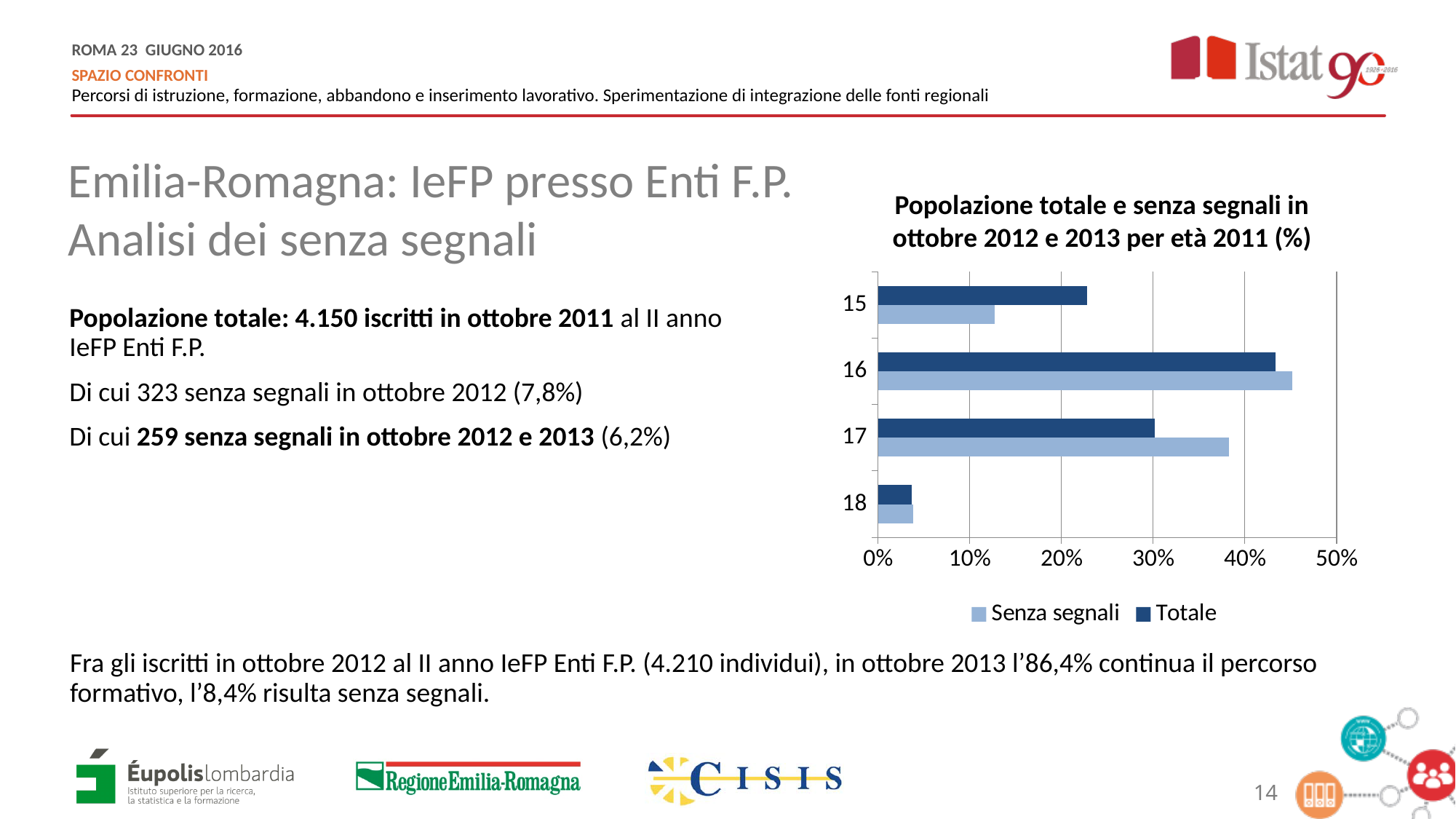
How many series does the chart legend list? 2 Which age category has the lowest value for the Senza segnali series? 18 Is the Senza segnali value for age 17 greater or less than 30%? greater How many age categories are shown on the chart? 4 For age 15, which series has the larger value, Senza segnali or Totale? Totale Is the Senza segnali value for age 18 greater or less than 10%? less Is the Totale value for age 15 greater or less than 20%? greater What kind of chart is shown on the slide? Bar chart For age 17, which series has the larger value, Senza segnali or Totale? Senza segnali Which age category has the highest value for the Totale series? 16 What is the title of the chart? Popolazione totale e senza segnali in ottobre 2012 e 2013 per età 2011 (%)